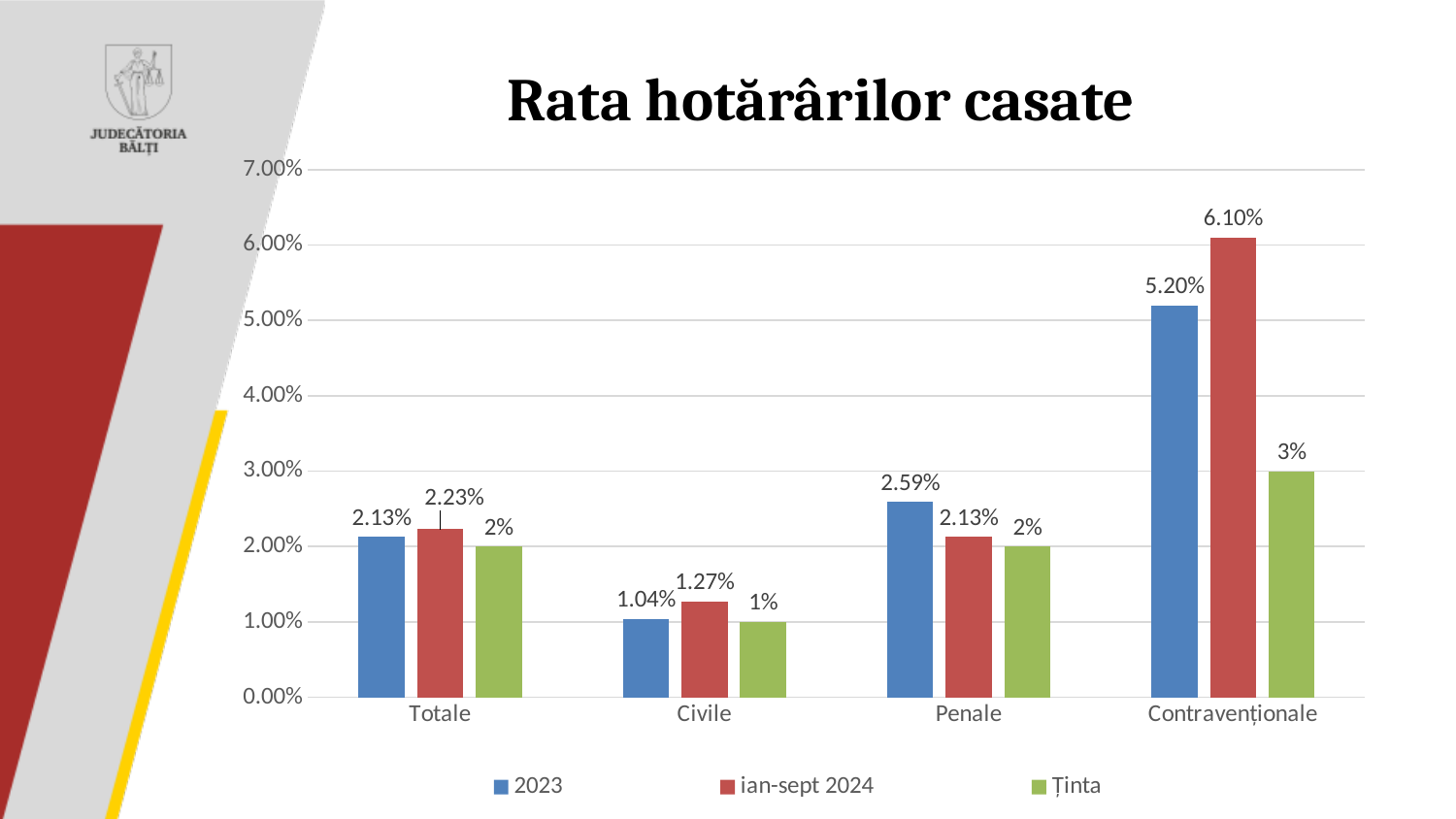
Is the ian-sept 2024 value for Contravenționale greater or less than 6.00%? greater What is the title of the chart? Rata hotărârilor casate How many series does the legend list? 3 Which category has the highest value in the 2023 series? Contravenționale What kind of chart is shown on the slide? bar chart For Penale, which is larger: the 2023 value or the ian-sept 2024 value? 2023 What is the difference between the ian-sept 2024 and 2023 values for Contravenționale? 0.90% How many categories are shown on the x axis? 4 What is the 2023 value for Civile? 1.04% Which category has the lowest value in the ian-sept 2024 series? Civile What is the value for Contravenționale in the ian-sept 2024 series? 6.10% What is the Ținta value for Penale? 2%